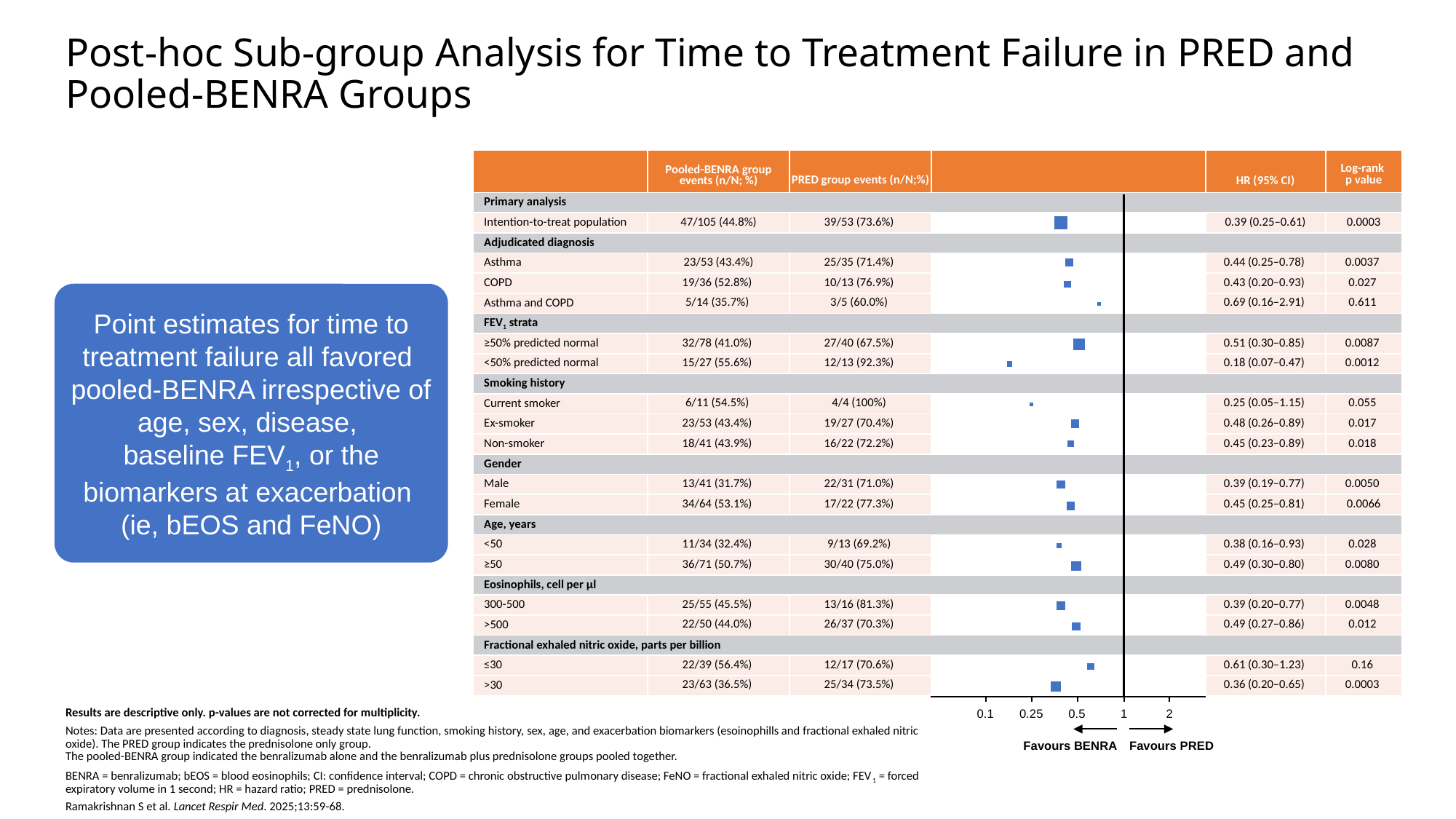
Which direction on the x axis of the forest plot is labelled 'Favours PRED'? Right (toward 2) What are the PRED group events (n/N; %) for current smokers? 4/4 (100%) How many subgroup rows have a hazard ratio plotted in the forest plot? 17 What is the hazard ratio (95% CI) for the intention-to-treat population? 0.39 (0.25–0.61) What is the difference in percentage points between the PRED group event rate and the pooled-BENRA group event rate in the intention-to-treat population? 28.8 percentage points What kind of chart is shown on the slide? Forest plot Is the hazard ratio point estimate for the ≥50 years age subgroup greater or less than 1? less Which has the larger hazard ratio point estimate, the ≤30 or the >30 fractional exhaled nitric oxide subgroup? ≤30 Which subgroup has the highest hazard ratio point estimate in the forest plot? Asthma and COPD What is the difference between the hazard ratio point estimates for Female and Male? 0.06 What is the log-rank p value for the COPD subgroup? 0.027 Which subgroup has the lowest hazard ratio point estimate in the forest plot? <50% predicted normal